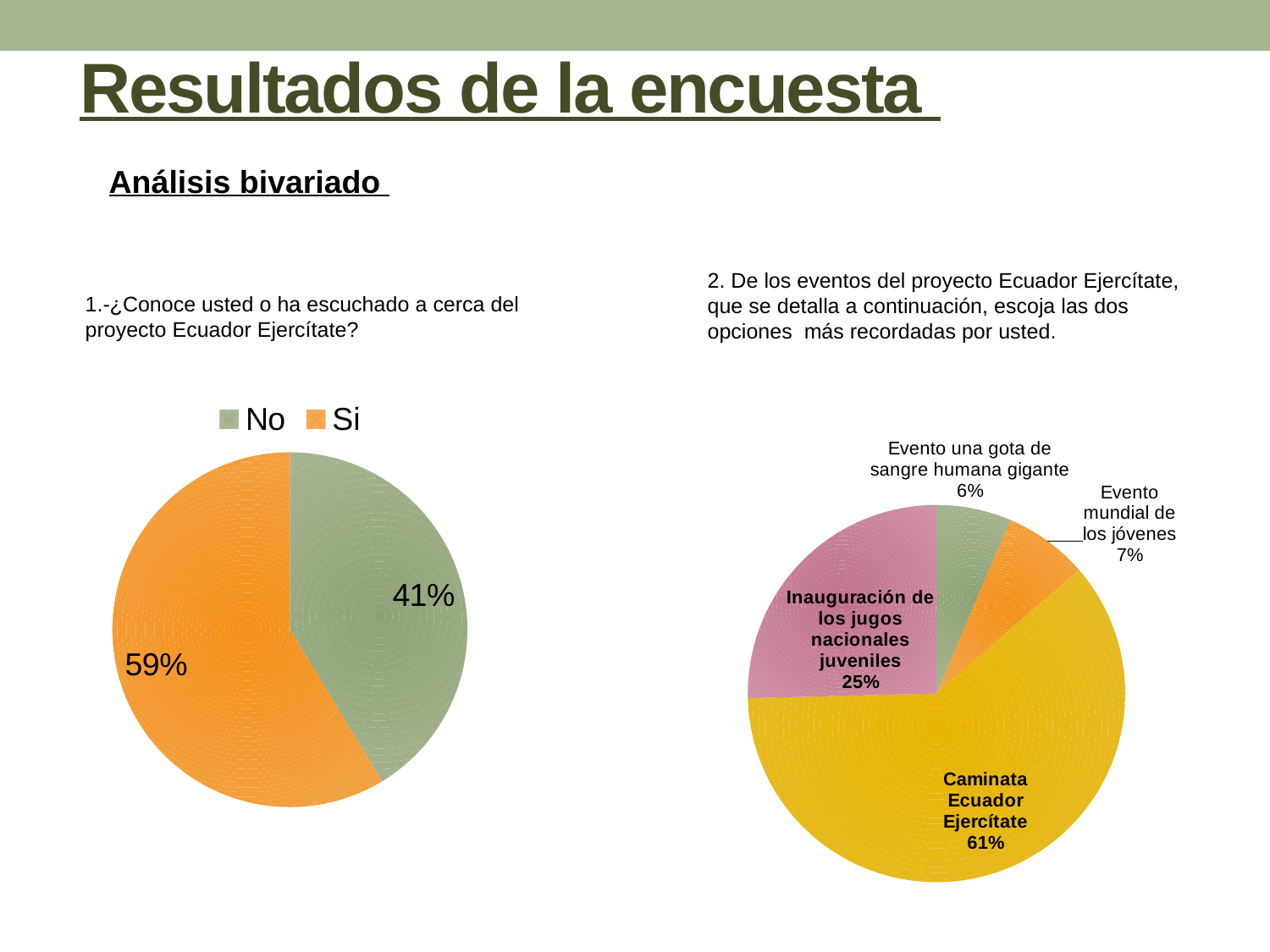
In the left pie chart, which answer has the larger share, "No" or "Si"? Si In the left pie chart, what percentage of respondents answered "Si"? 59% In the right pie chart, what share does "Evento mundial de los jóvenes" have? 7% In the right pie chart, what share does "Caminata Ecuador Ejercítate" have? 61% In the left pie chart, what percentage of respondents answered "No"? 41% What type of chart is used on the right side of the slide? Pie chart How many slices does the right pie chart have? 4 In the right pie chart, what is the difference in percentage points between "Caminata Ecuador Ejercítate" and "Inauguración de los jugos nacionales juveniles"? 36 In the left pie chart, what is the difference in percentage points between the "Si" and "No" slices? 18 In the right pie chart, what share does "Inauguración de los jugos nacionales juveniles" have? 25% How many entries does the legend of the left pie chart list? 2 In the right pie chart, which event has the smallest slice? Evento una gota de sangre humana gigante